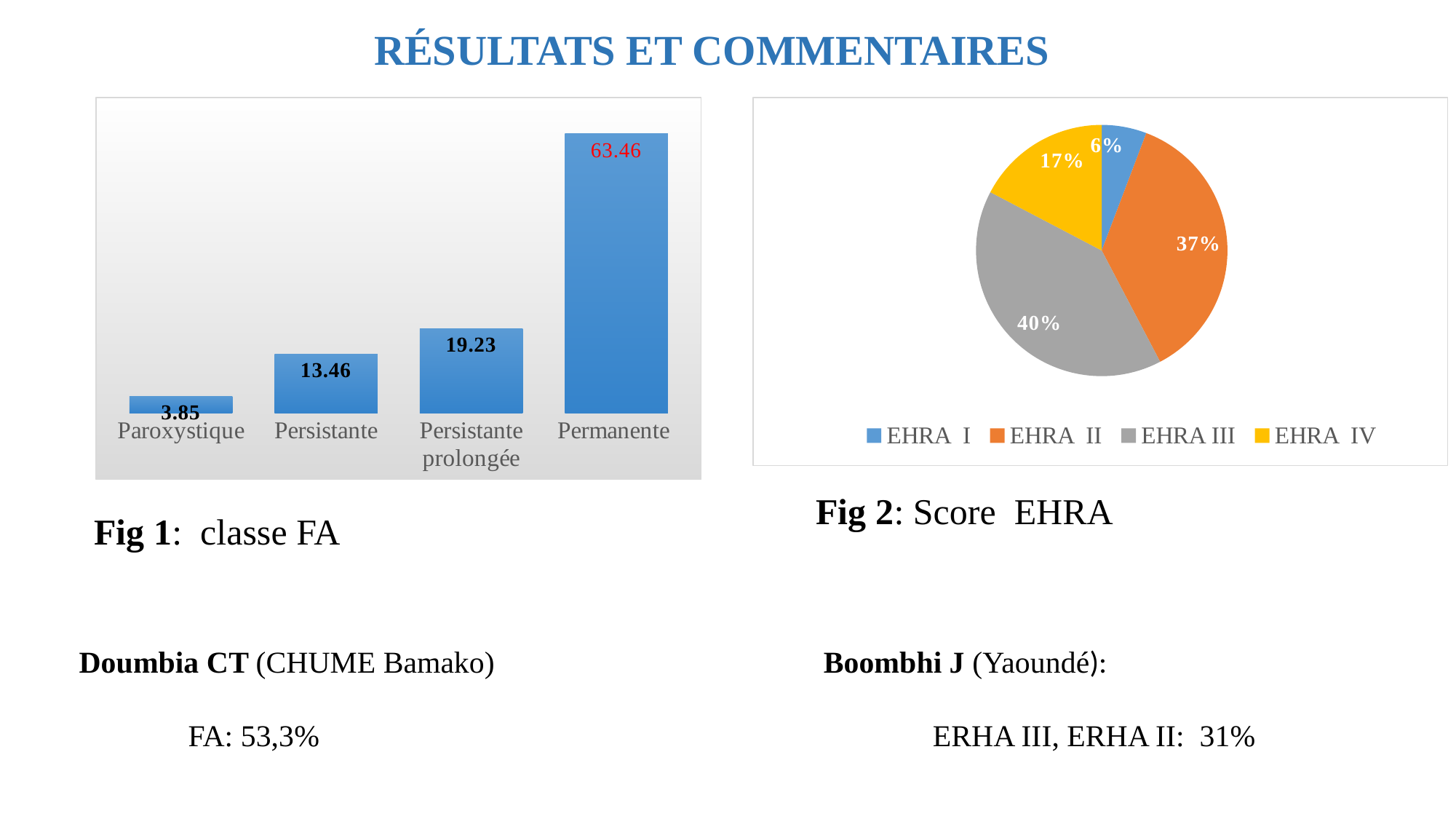
In the Fig 1 (classe FA) bar chart, do the values rise or fall from left to right? Rise In the Fig 2 (Score EHRA) pie chart, what share does EHRA II have? 37% In the Fig 1 (classe FA) bar chart, which category has the highest value? Permanente In the Fig 2 (Score EHRA) pie chart, which is larger, EHRA IV or EHRA I? EHRA IV In the Fig 2 (Score EHRA) pie chart, which category has the largest slice? EHRA III In the Fig 1 (classe FA) bar chart, how many categories are shown? 4 In the Fig 1 (classe FA) bar chart, which category has the lowest value? Paroxystique In the Fig 1 (classe FA) bar chart, what is the value for Permanente? 63.46 How many entries does the legend of the Fig 2 (Score EHRA) pie chart list? 4 What type of chart is Fig 1 (classe FA)? Bar chart In the Fig 1 (classe FA) bar chart, what is the value for Paroxystique? 3.85 In the Fig 1 (classe FA) bar chart, what is the difference between the values for Persistante prolongée and Persistante? 5.77